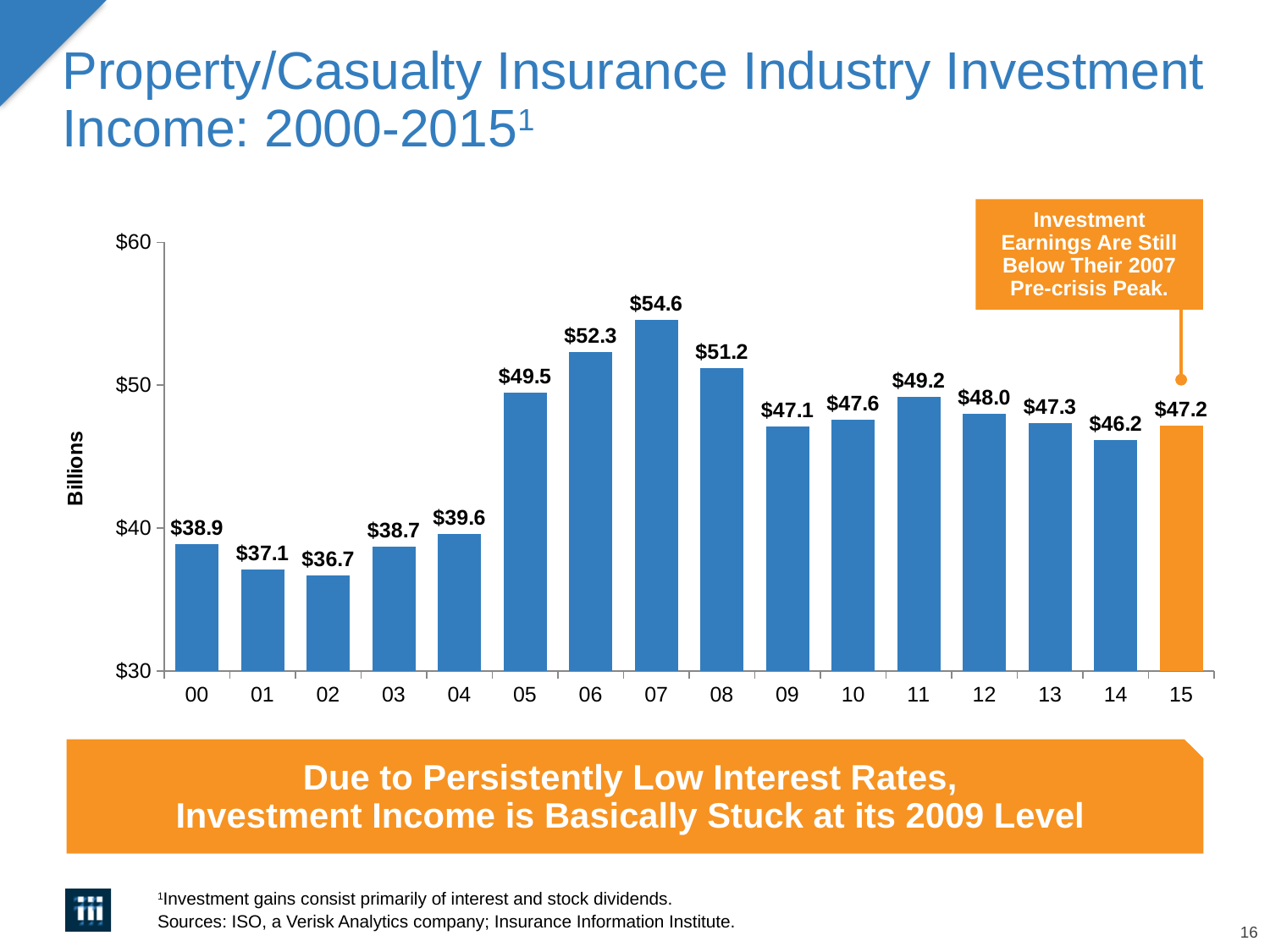
What is the label on the vertical axis of the chart? Billions Which year has the lowest investment income on the chart? 02 What is the difference between the 2006 value and the 2005 value? $2.8 How many years are shown on the x axis of the chart? 16 What kind of chart is shown on the slide? bar chart Which year has the highest investment income on the chart? 07 What is the investment income value shown for 2002? $36.7 Which year has the larger value, 2011 or 2012? 11 Is the value for 2008 greater or less than $50? greater What is the investment income value shown for 2007? $54.6 What is the difference between the 2007 value and the 2015 value? $7.4 What is the investment income value shown for 2015? $47.2